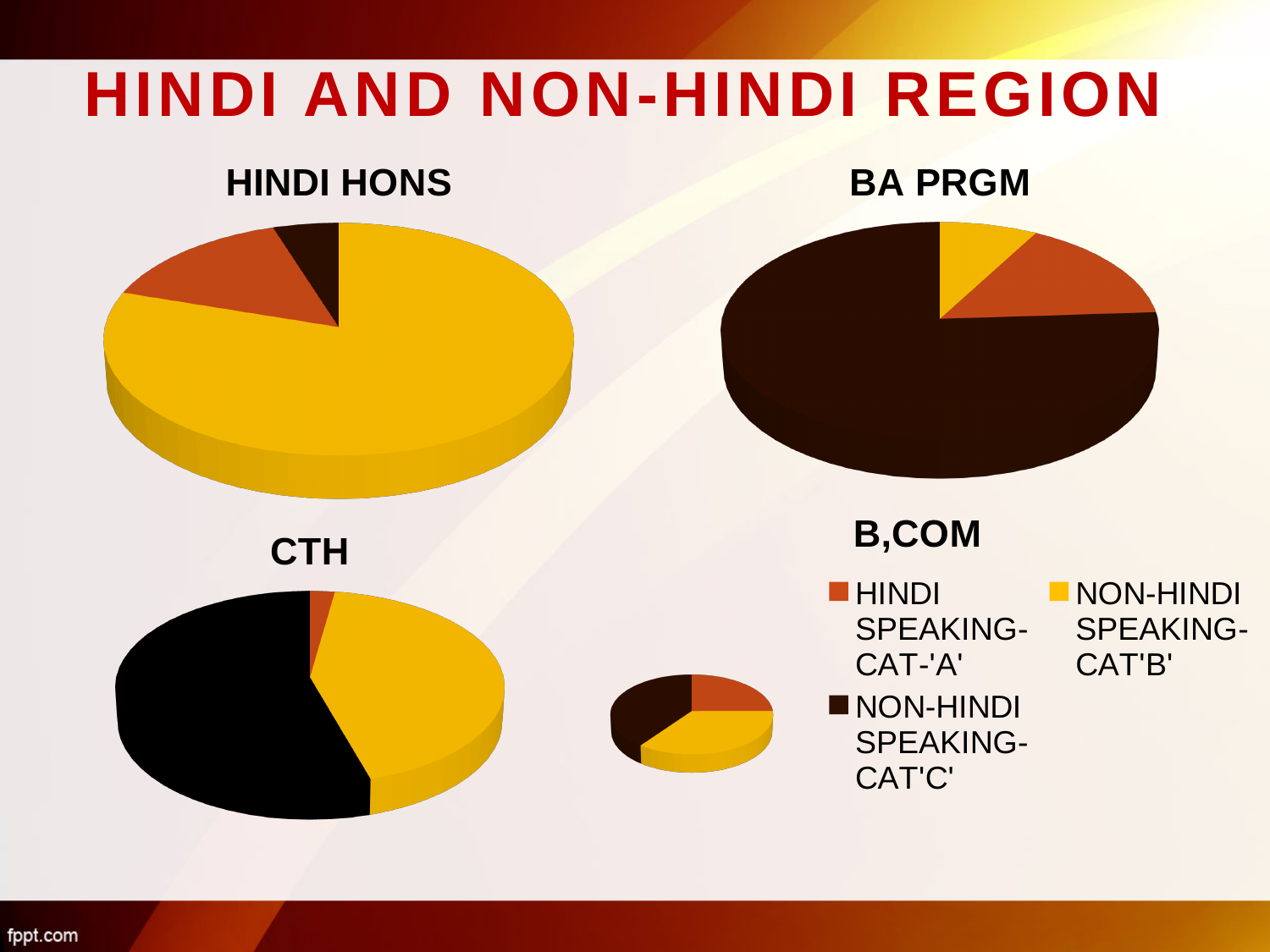
How many pie charts are shown on the slide? 4 Which colour represents NON-HINDI SPEAKING-CAT'B' in the legend? yellow In the HINDI HONS chart, which category has the smallest slice? NON-HINDI SPEAKING-CAT'C' How many slices does the CTH pie chart have? 3 What kind of chart is the HINDI HONS chart? pie chart In the BA PRGM chart, which category has the largest slice? NON-HINDI SPEAKING-CAT'C' How many categories does the legend list? 3 In the HINDI HONS chart, which slice is larger: HINDI SPEAKING-CAT-'A' or NON-HINDI SPEAKING-CAT'C'? HINDI SPEAKING-CAT-'A'